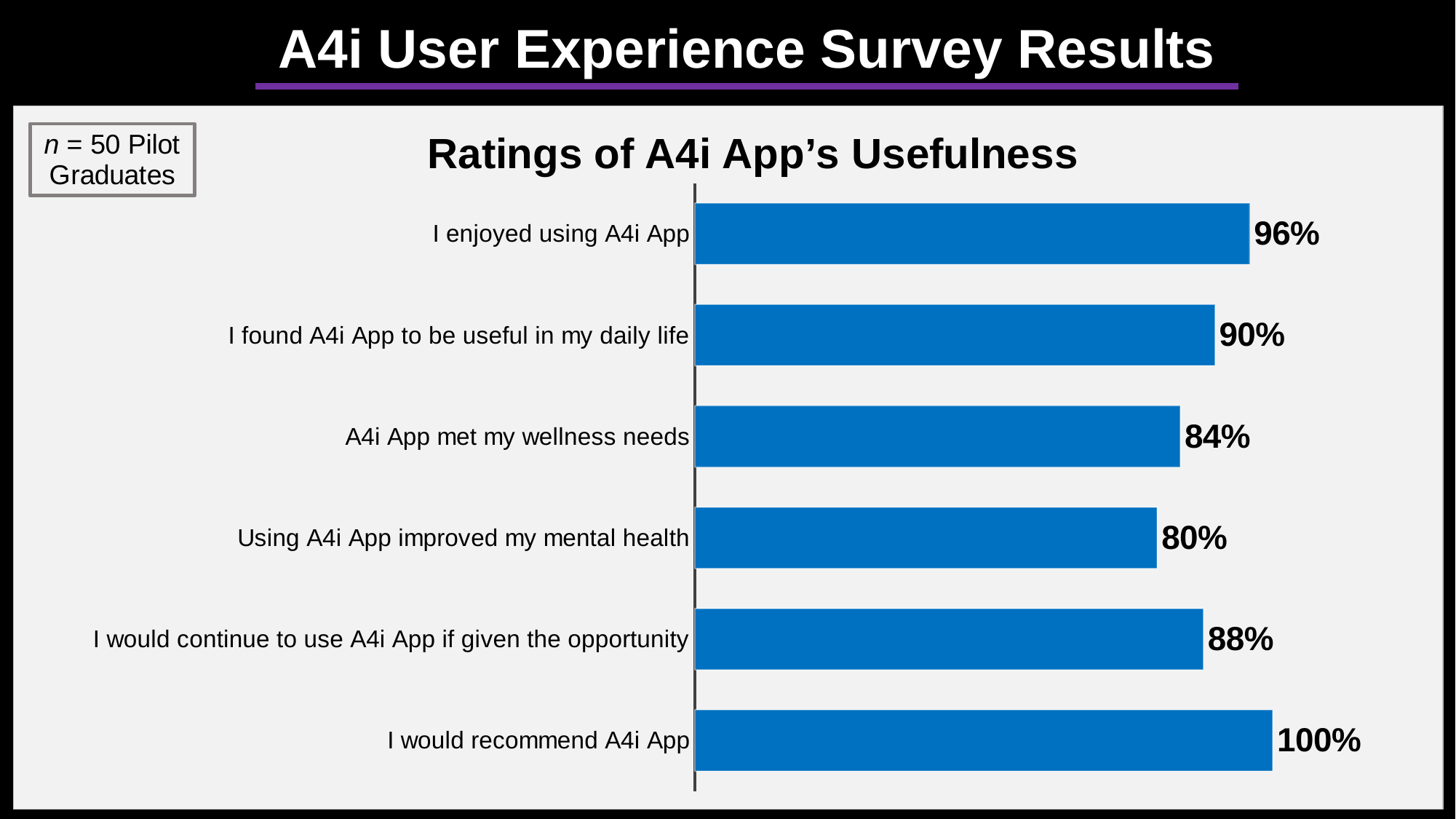
What is the value for "I enjoyed using A4i App"? 96% What kind of chart is shown on the slide? Bar chart What is the value for "A4i App met my wellness needs"? 84% How many pilot graduates responded to the survey, according to the slide? 50 What is the value for "I would continue to use A4i App if given the opportunity"? 88% Which is larger: the rating for "I found A4i App to be useful in my daily life" or "A4i App met my wellness needs"? I found A4i App to be useful in my daily life What is the difference between the rating for "I enjoyed using A4i App" and "Using A4i App improved my mental health"? 16% Which statement has the lowest rating? Using A4i App improved my mental health What is the title of the chart? Ratings of A4i App's Usefulness What is the difference between the rating for "I would recommend A4i App" and "I found A4i App to be useful in my daily life"? 10% Which statement has the highest rating? I would recommend A4i App How many statements are rated in the chart? 6